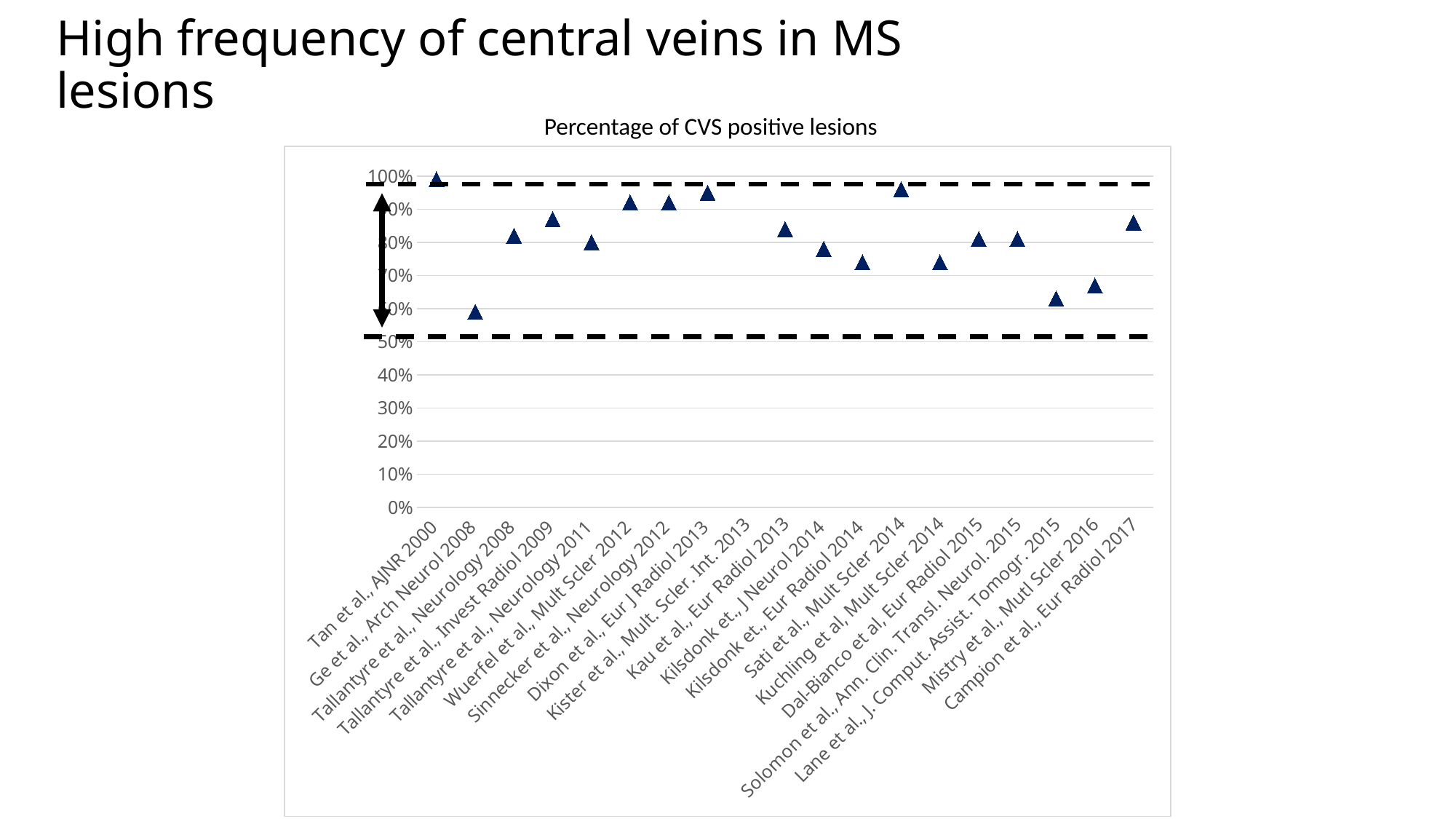
Is the value for Kuchling et al, Mult Scler 2014 greater or less than 80%? less Which study has the highest percentage of CVS positive lesions? Tan et al., AJNR 2000 Is the value for Ge et al., Arch Neurol 2008 greater or less than 70%? less Which has a lower percentage of CVS positive lesions: Tan et al., AJNR 2000 or Ge et al., Arch Neurol 2008? Ge et al., Arch Neurol 2008 Which has a higher percentage of CVS positive lesions: Wuerfel et al., Mult Scler 2012 or Lane et al., J. Comput. Assist. Tomogr. 2015? Wuerfel et al., Mult Scler 2012 What is the highest value shown on the y axis of the chart? 100% What is the title of the chart? Percentage of CVS positive lesions Which study has the lowest percentage of CVS positive lesions? Ge et al., Arch Neurol 2008 Is the value for Lane et al., J. Comput. Assist. Tomogr. 2015 greater or less than 50%? greater How many studies (categories) are listed along the x axis of the chart? 19 What kind of chart is shown on the slide? Scatter chart